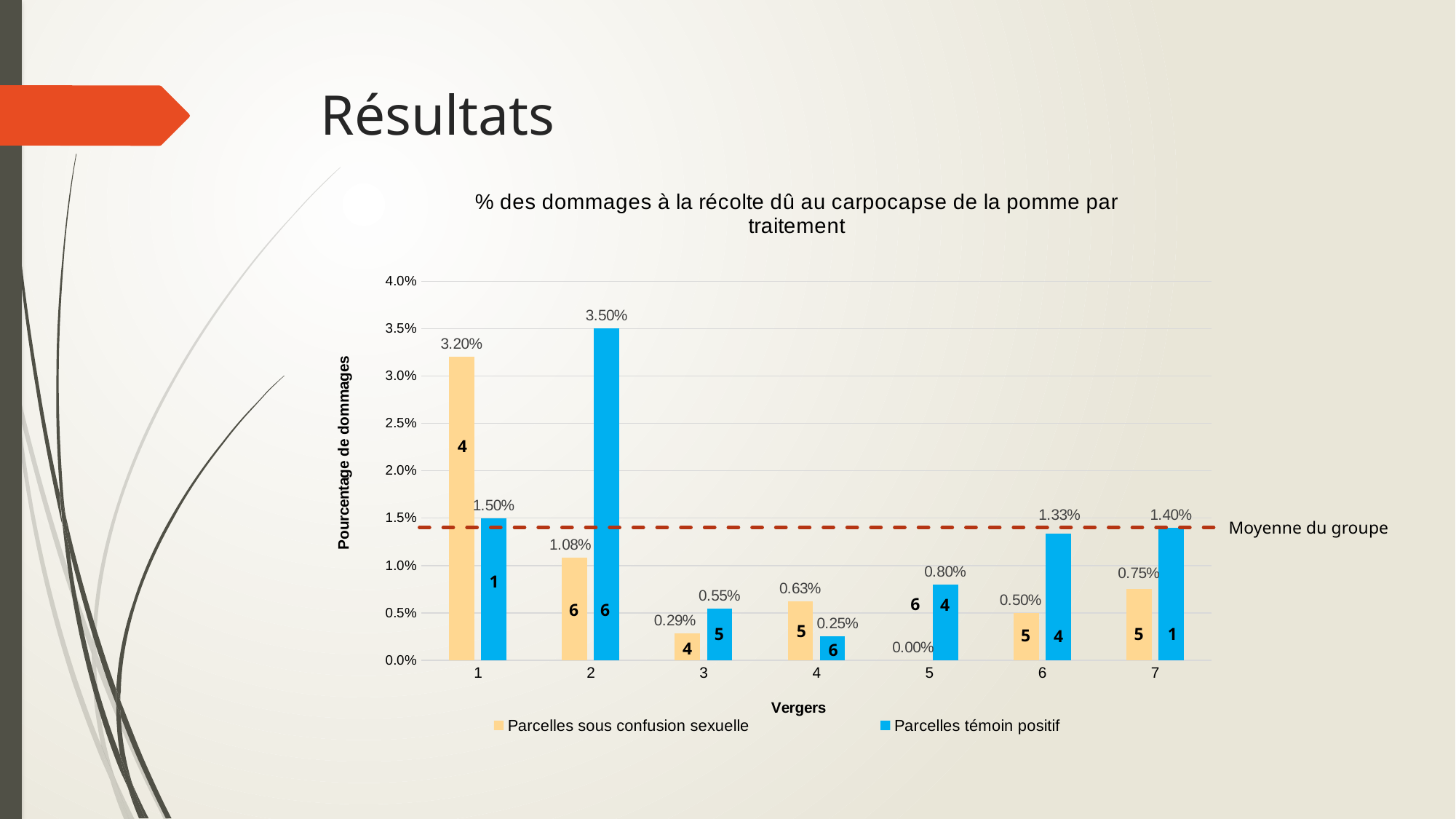
What is the difference between Parcelles témoin positif and Parcelles sous confusion sexuelle at verger 2? 2.42% What is the value for Parcelles sous confusion sexuelle at verger 1? 3.20% Which verger has the highest value for Parcelles témoin positif? 2 What is the difference between Parcelles sous confusion sexuelle and Parcelles témoin positif at verger 1? 1.70% How many series does the legend list? 2 What is the value for Parcelles témoin positif at verger 2? 3.50% What is the value for Parcelles sous confusion sexuelle at verger 5? 0.00% What does the dashed horizontal line represent? Moyenne du groupe At verger 4, which series has the larger value? Parcelles sous confusion sexuelle Which verger has the lowest value for Parcelles sous confusion sexuelle? 5 What is the value for Parcelles témoin positif at verger 6? 1.33% How many vergers are shown on the x axis? 7